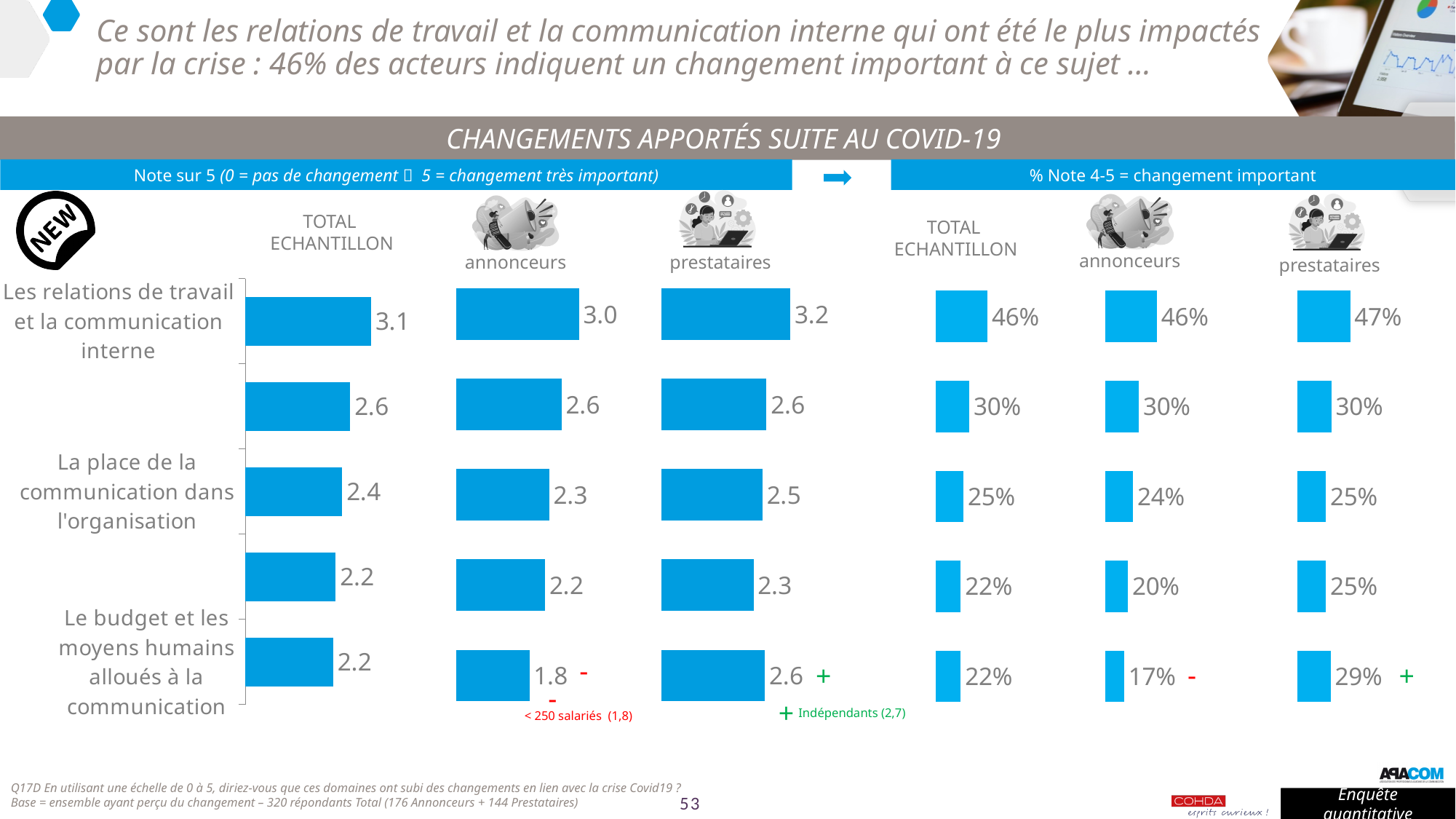
What type of chart is used to show the 'Note sur 5' TOTAL ECHANTILLON values? Bar chart In the 'Note sur 5' TOTAL ECHANTILLON chart, what is the value for 'Les relations de travail et la communication interne'? 3.1 In the 'Note sur 5' TOTAL ECHANTILLON chart, which category has the highest value? Les relations de travail et la communication interne In the '% Note 4-5' annonceurs chart, which category has the lowest value? Le budget et les moyens humains alloués à la communication For 'La place de la communication dans l'organisation' in the 'Note sur 5' charts, which is larger: the annonceurs value or the prestataires value? prestataires In the 'Note sur 5' annonceurs chart, what is the value for 'Le budget et les moyens humains alloués à la communication'? 1.8 In the 'Note sur 5' charts, what is the difference between the prestataires value and the annonceurs value for 'Le budget et les moyens humains alloués à la communication'? 0.8 In the '% Note 4-5' annonceurs chart, what is the value for 'Le budget et les moyens humains alloués à la communication'? 17% In the '% Note 4-5' charts, what is the difference between the prestataires value and the annonceurs value for 'Le budget et les moyens humains alloués à la communication'? 12% In the '% Note 4-5' TOTAL ECHANTILLON chart, what is the value for 'Les relations de travail et la communication interne'? 46% In the 'Note sur 5' prestataires chart, what is the value for 'La place de la communication dans l'organisation'? 2.5 In the '% Note 4-5' prestataires chart, what is the value for 'Le budget et les moyens humains alloués à la communication'? 29%